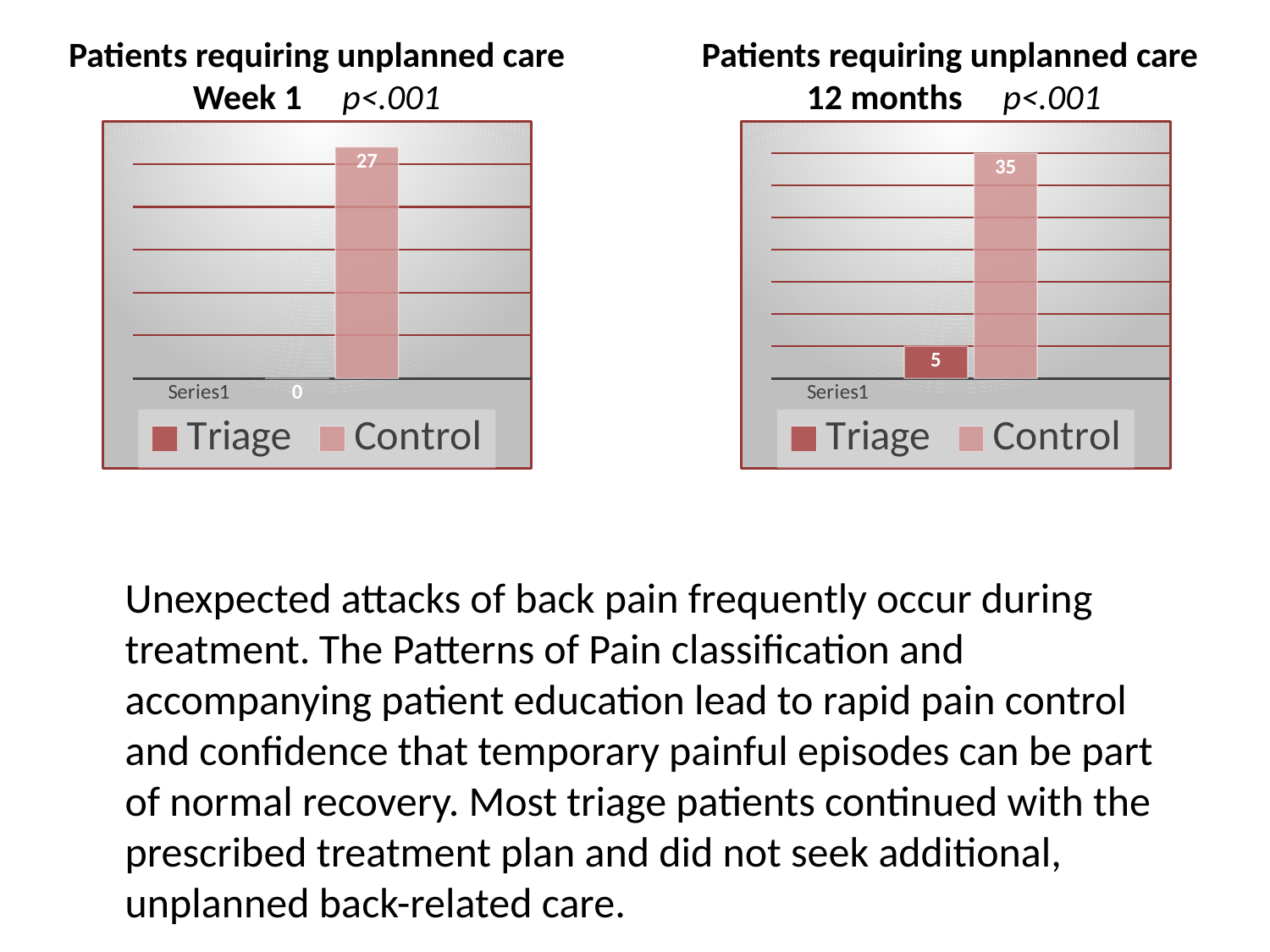
In the 'Patients requiring unplanned care 12 months' chart, which series has the higher value, Triage or Control? Control In the 'Patients requiring unplanned care Week 1' chart, which series has the lowest value? Triage In the 'Patients requiring unplanned care 12 months' chart, what is the difference between the Control and Triage values? 30 In the 'Patients requiring unplanned care 12 months' chart, what is the value for Control? 35 In the 'Patients requiring unplanned care 12 months' chart, what is the value for Triage? 5 In the 'Patients requiring unplanned care Week 1' chart, what is the difference between the Control and Triage values? 27 What kind of chart is the 'Patients requiring unplanned care Week 1' chart? Bar chart What p-value is shown in the title of the 'Patients requiring unplanned care 12 months' chart? p<.001 In the 'Patients requiring unplanned care Week 1' chart, what is the value for Triage? 0 What are the two legend entries in the 'Patients requiring unplanned care Week 1' chart? Triage and Control How many series does the legend list in the 'Patients requiring unplanned care 12 months' chart? 2 In the 'Patients requiring unplanned care Week 1' chart, what is the value for Control? 27